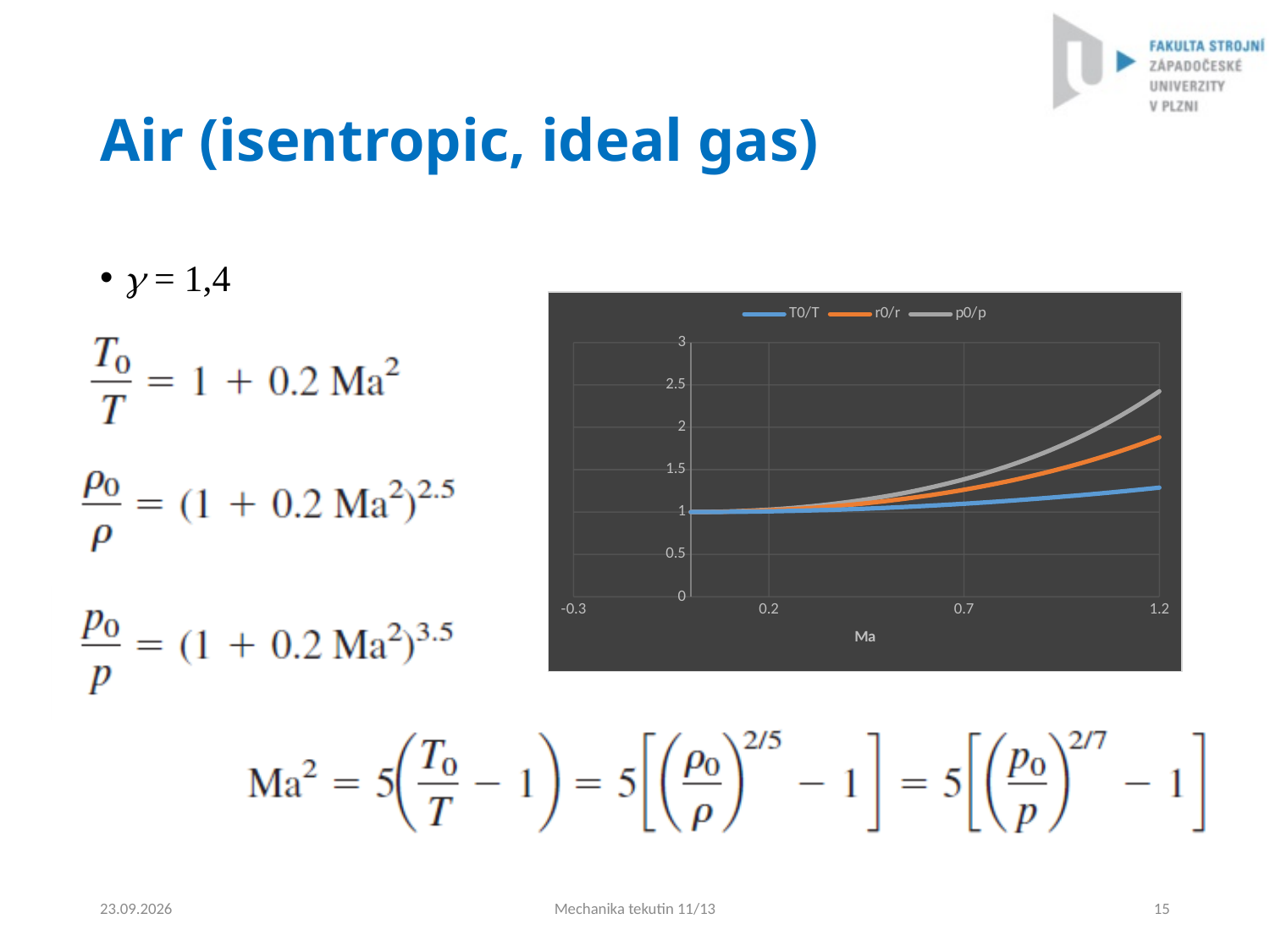
Is the value of p0/p at Ma = 1.2 greater or less than 2? greater Is the value of r0/r at Ma = 1.2 greater or less than 2? less What kind of chart is shown on the slide? line chart Do the values of the p0/p series rise or fall as Ma increases along the x axis? rise What are the series names listed in the chart's legend? T0/T, r0/r, p0/p Is the value of T0/T at Ma = 1.2 greater or less than 1.5? less How many series does the chart's legend list? 3 Do the values of the T0/T series rise or fall as Ma increases along the x axis? rise At Ma = 1.2, which is larger: the value of p0/p or the value of T0/T? p0/p What is the label of the chart's x axis? Ma At Ma = 1.2, which series has the highest value? p0/p